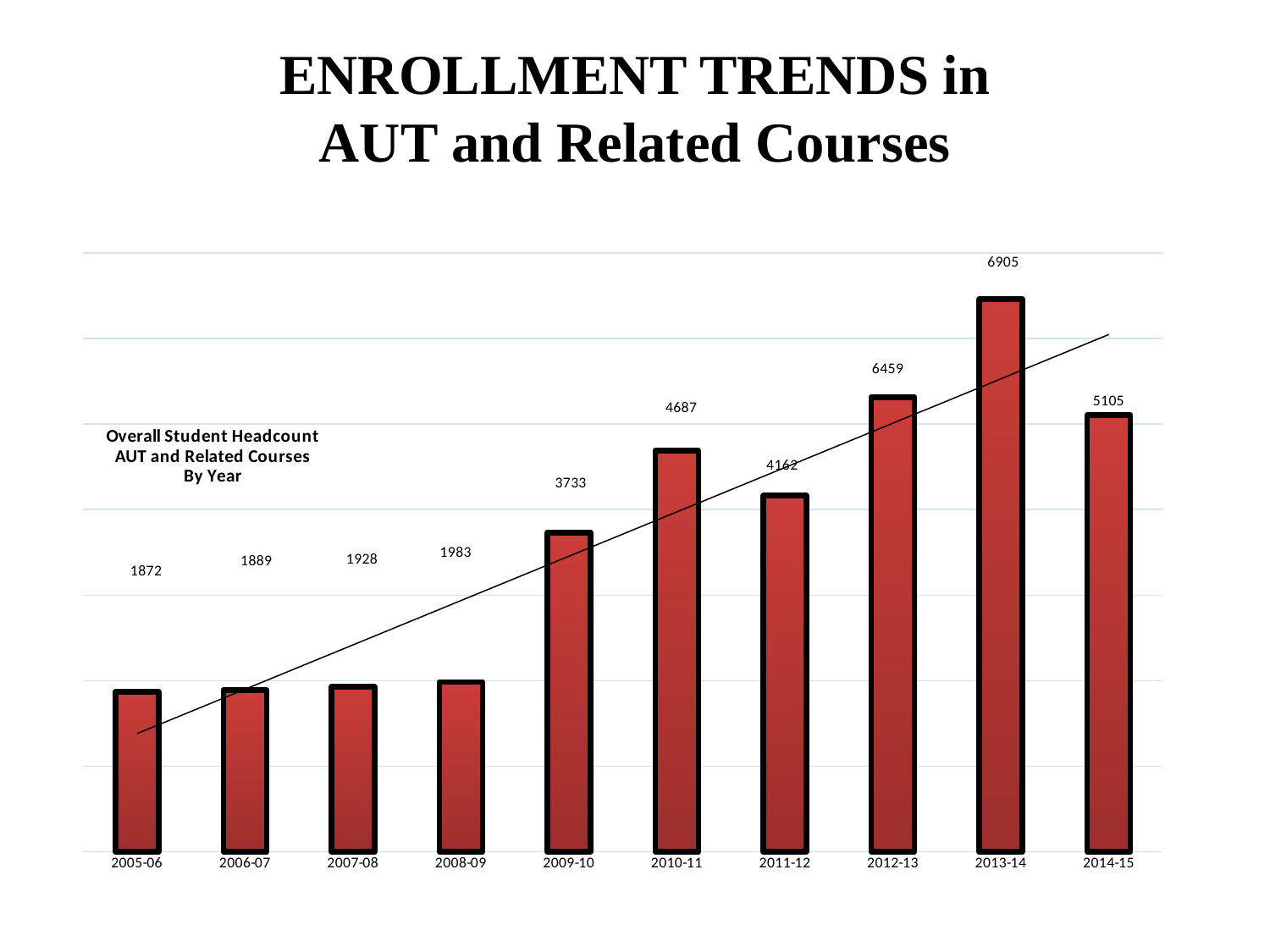
What is the title shown inside the chart area? Overall Student Headcount AUT and Related Courses By Year Which year has the highest student headcount? 2013-14 Which year has the lowest student headcount? 2005-06 How many years are shown on the chart? 10 What is the student headcount for 2013-14? 6905 What is the difference in headcount between 2009-10 and 2008-09? 1750 What kind of chart is this? Bar chart What is the difference in headcount between 2013-14 and 2014-15? 1800 What is the student headcount for 2005-06? 1872 Which year has a larger headcount, 2010-11 or 2011-12? 2010-11 What is the student headcount for 2014-15? 5105 What is the student headcount for 2011-12? 4162